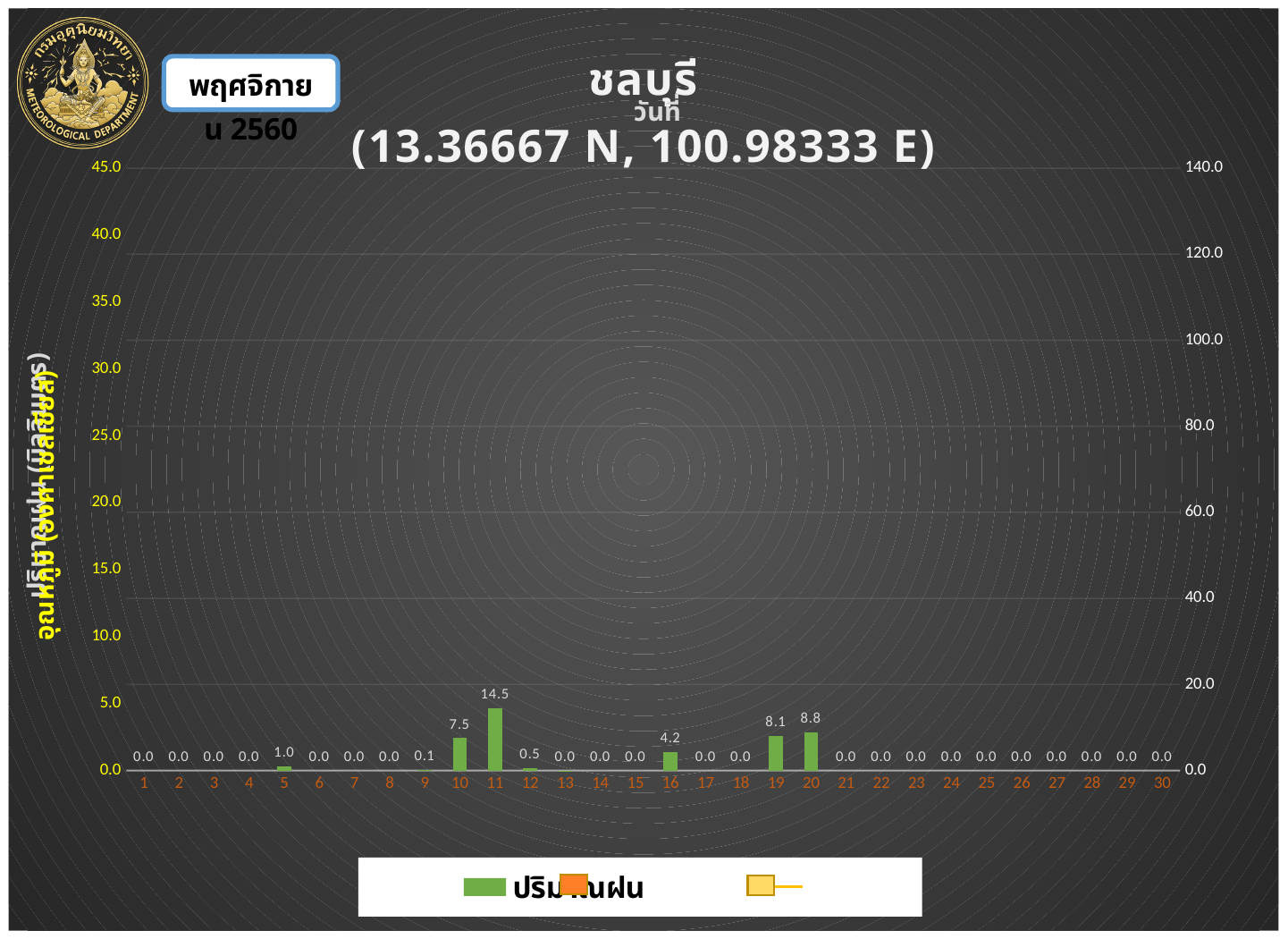
What is the rainfall value for day 11? 14.5 What kind of chart is shown on the slide? bar chart What is the difference between the rainfall values for day 11 and day 10? 7.0 How many days are shown on the x axis? 30 What is the rainfall value for day 16? 4.2 Which has a larger rainfall value, day 10 or day 20? day 20 What is the rainfall value for day 20? 8.8 What is the rainfall value for day 5? 1.0 What station name is shown in the chart title? ชลบุรี What is the rainfall value for day 10? 7.5 Which day has the highest rainfall value? 11 What is the difference between the rainfall values for day 20 and day 19? 0.7